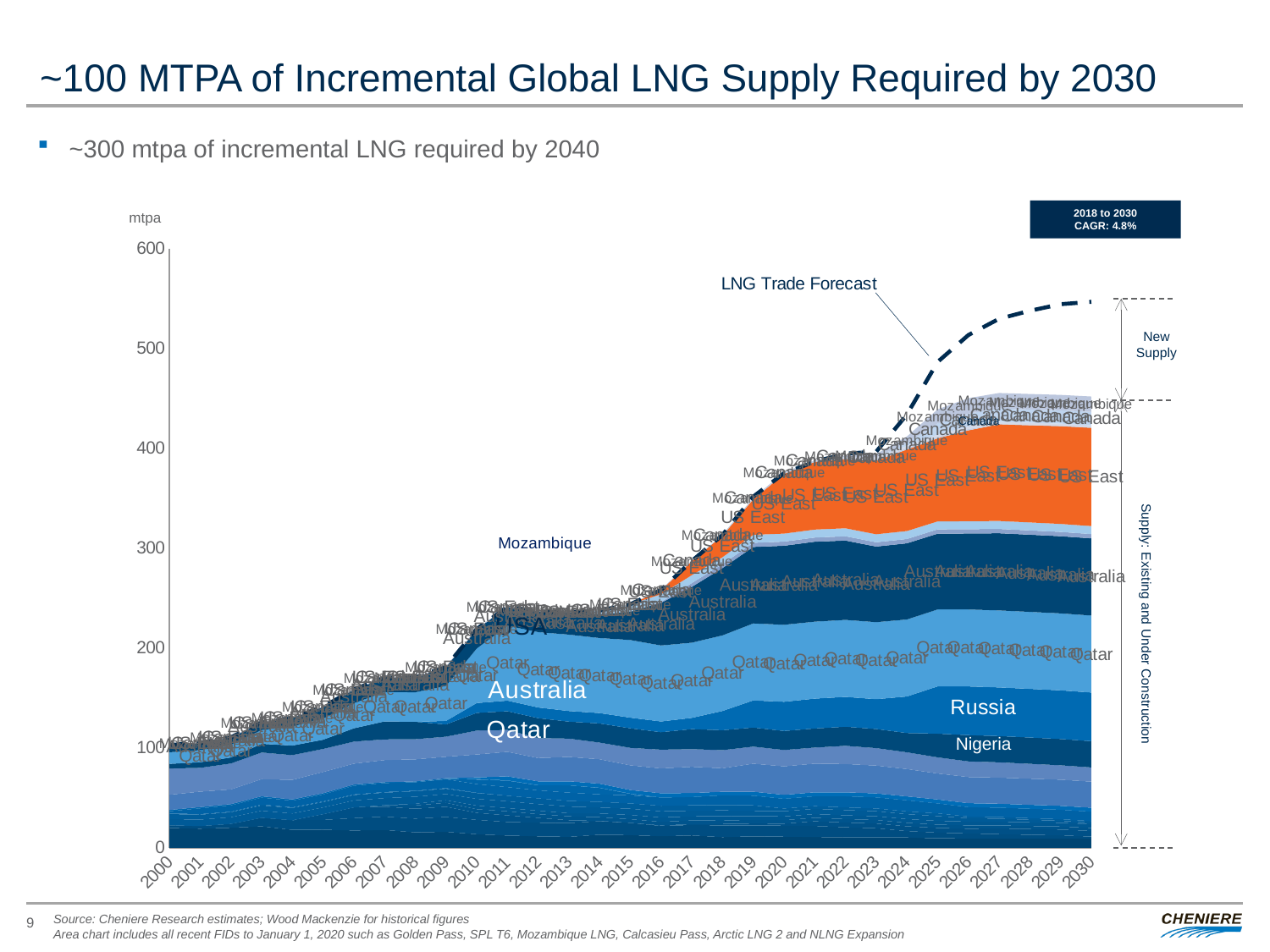
How many year ticks are shown on the x axis of the chart? 31 Is the LNG Trade Forecast value in 2030 greater or less than 500 mtpa? greater Is the total existing and under-construction supply in 2030 greater or less than 400 mtpa? greater What is the 2018 to 2030 CAGR stated in the box on the chart? 4.8% What is the first year shown on the x axis of the chart? 2000 Does total LNG supply in the area chart rise or fall from 2000 to 2030? Rise What kind of chart is shown on the slide? Stacked area chart What does the dashed line on the chart represent? LNG Trade Forecast What unit is shown on the y axis of the chart? mtpa Is the total LNG supply in 2010 greater or less than 300 mtpa? less What is the last year shown on the x axis of the chart? 2030